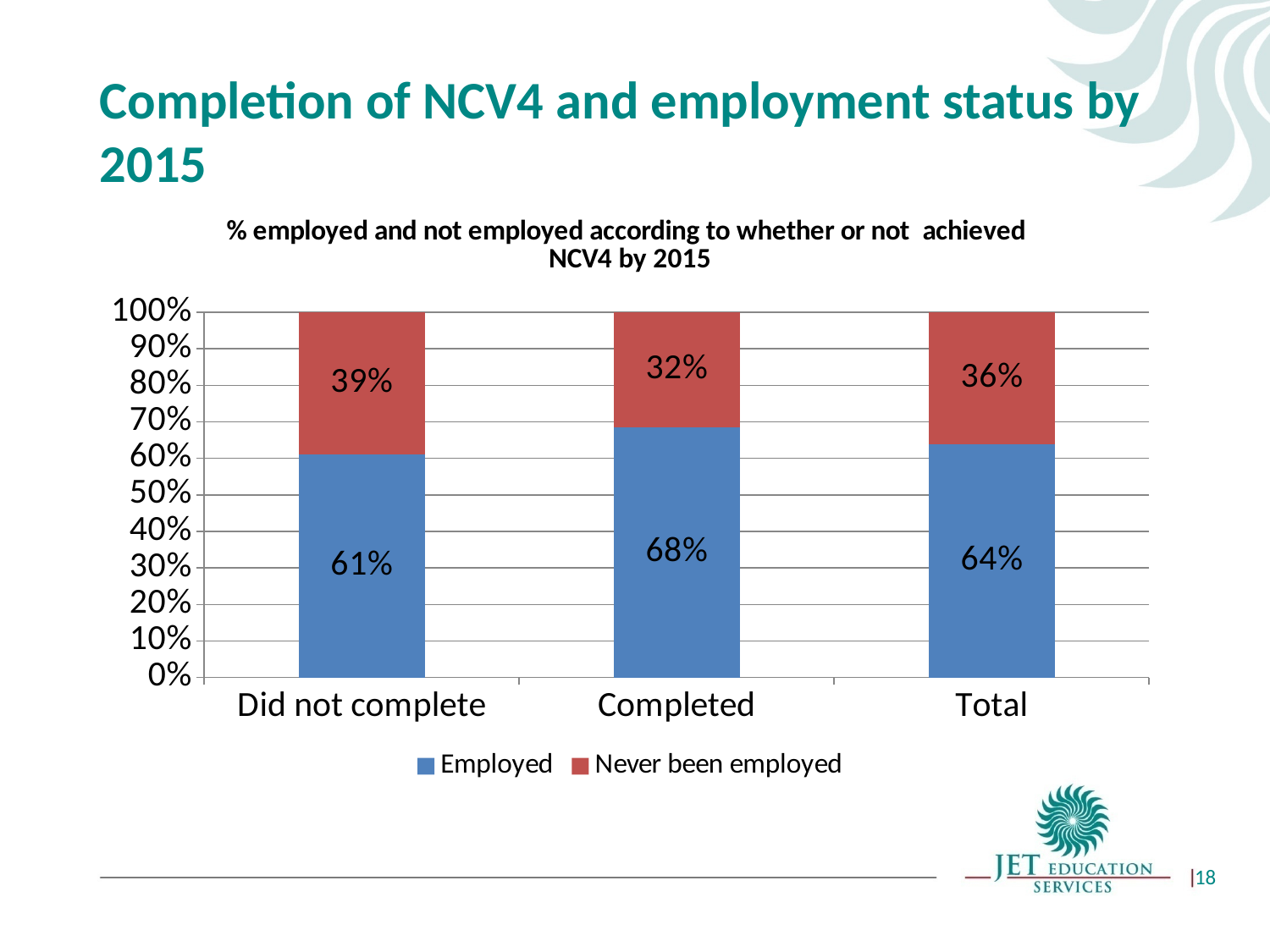
What is the Employed value for the 'Total' category? 64% What percentage of the 'Completed' group is Employed? 68% Which category has the highest Employed percentage? Completed What percentage of the 'Did not complete' group has Never been employed? 39% How many categories are shown on the x axis? 3 What kind of chart is shown on the slide? Stacked bar chart How many series does the legend list? 2 What is the difference between the Employed percentages for 'Completed' and 'Did not complete'? 7% What is the total of the stacked bar for 'Did not complete'? 100% Which colour represents the 'Never been employed' series? Red Is the Employed percentage larger for 'Did not complete' or for 'Total'? Total Which category has the lowest 'Never been employed' percentage? Completed